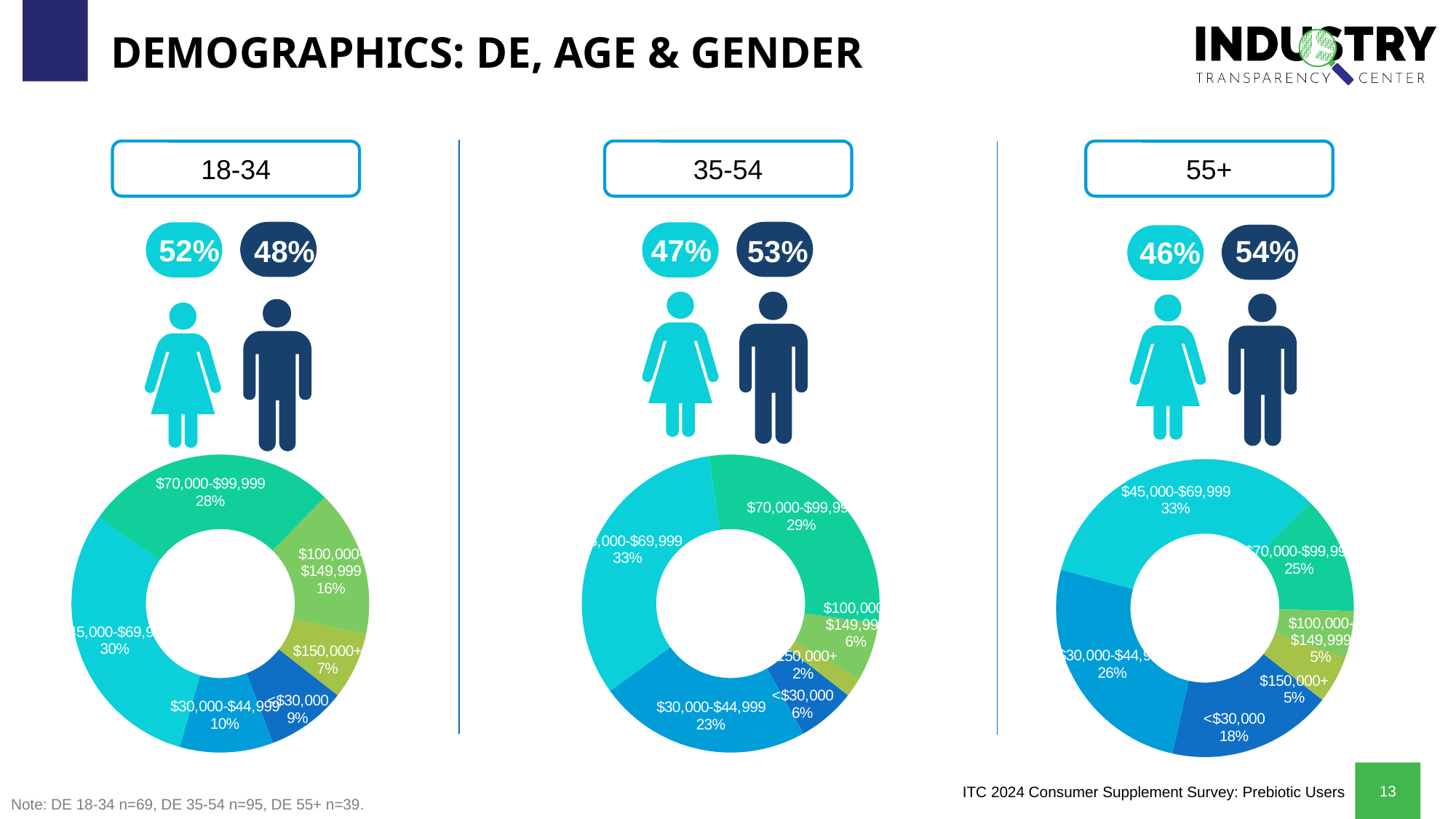
In the 35-54 donut chart, what is the combined percentage of the $100,000-$149,999 and $150,000+ brackets? 8% How many donut charts are on the slide? 3 How many income brackets are shown in the 55+ donut chart? 6 In the 55+ donut chart, which is larger: the share for $30,000-$44,999 or the share for $70,000-$99,999? $30,000-$44,999 In the 18-34 donut chart, which income bracket has the smallest share? $150,000+ In the 35-54 donut chart, what percentage is shown for the $30,000-$44,999 income bracket? 23% In the 35-54 donut chart, which income bracket has the smallest share? $150,000+ What type of chart is used to show income distribution for each age group? Donut chart In the 35-54 donut chart, which income bracket has the largest share? $45,000-$69,999 In the 55+ donut chart, what percentage is shown for the <$30,000 income bracket? 18% In the 18-34 donut chart, what percentage is shown for the $70,000-$99,999 income bracket? 28% In the 18-34 donut chart, what is the difference in percentage points between the $45,000-$69,999 and $100,000-$149,999 brackets? 14